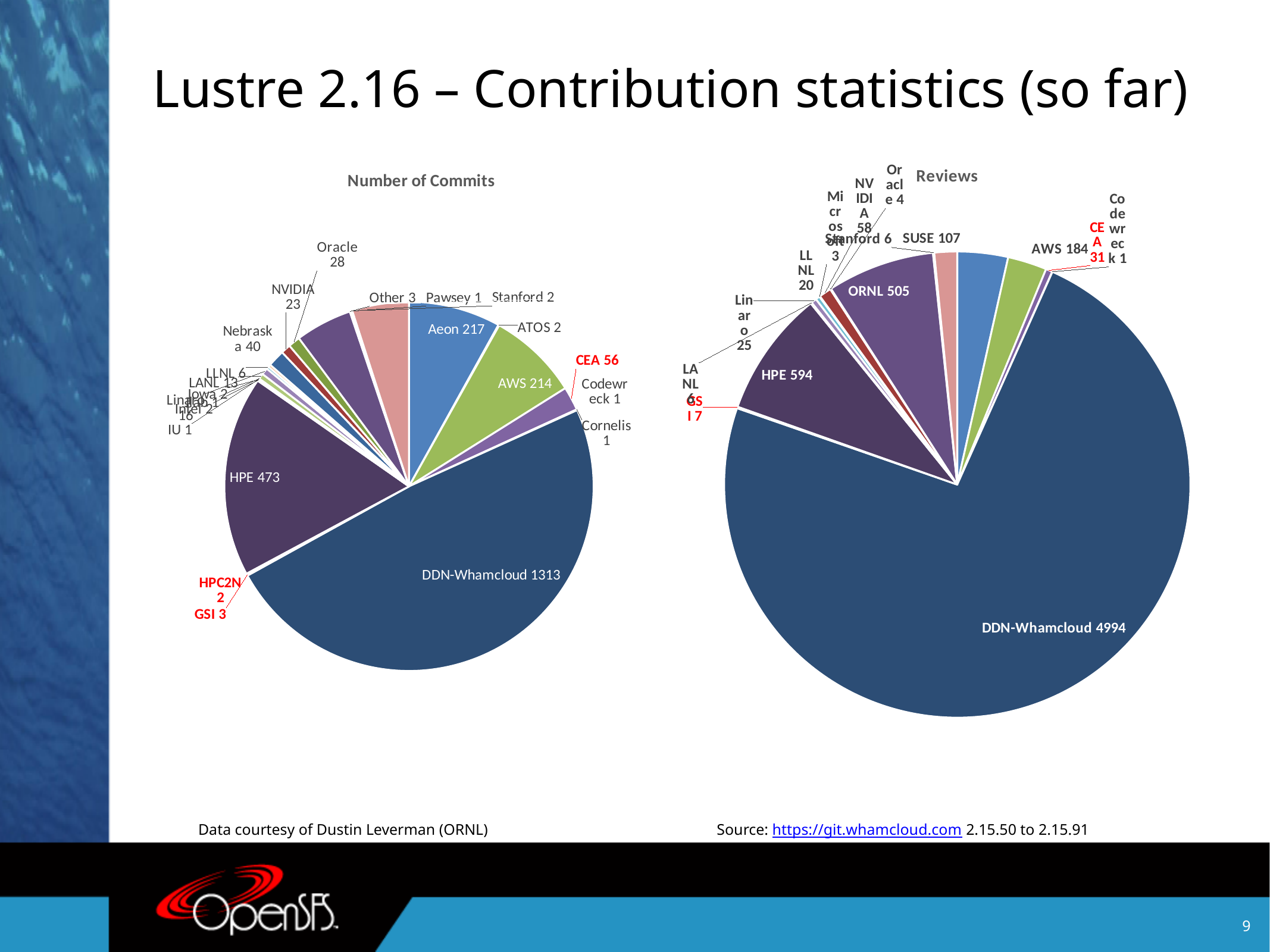
What is the title of the chart on the left side of the slide? Number of Commits In the Reviews chart, how many reviews does DDN-Whamcloud have? 4994 In the Number of Commits chart, how many commits does HPE have? 473 In the Reviews chart, how many reviews does ORNL have? 505 In the Reviews chart, which has more reviews, AWS or SUSE? AWS In the Number of Commits chart, what is the difference between Aeon's and AWS's commits? 3 In the Reviews chart, how many reviews does CEA have? 31 In the Reviews chart, what is the difference between HPE's and ORNL's reviews? 89 What type of chart is used for the Reviews data? Pie chart In the Number of Commits chart, which contributor has the largest slice? DDN-Whamcloud In the Number of Commits chart, how many commits does DDN-Whamcloud have? 1313 In the Number of Commits chart, which has more commits, Nebraska or Oracle? Nebraska